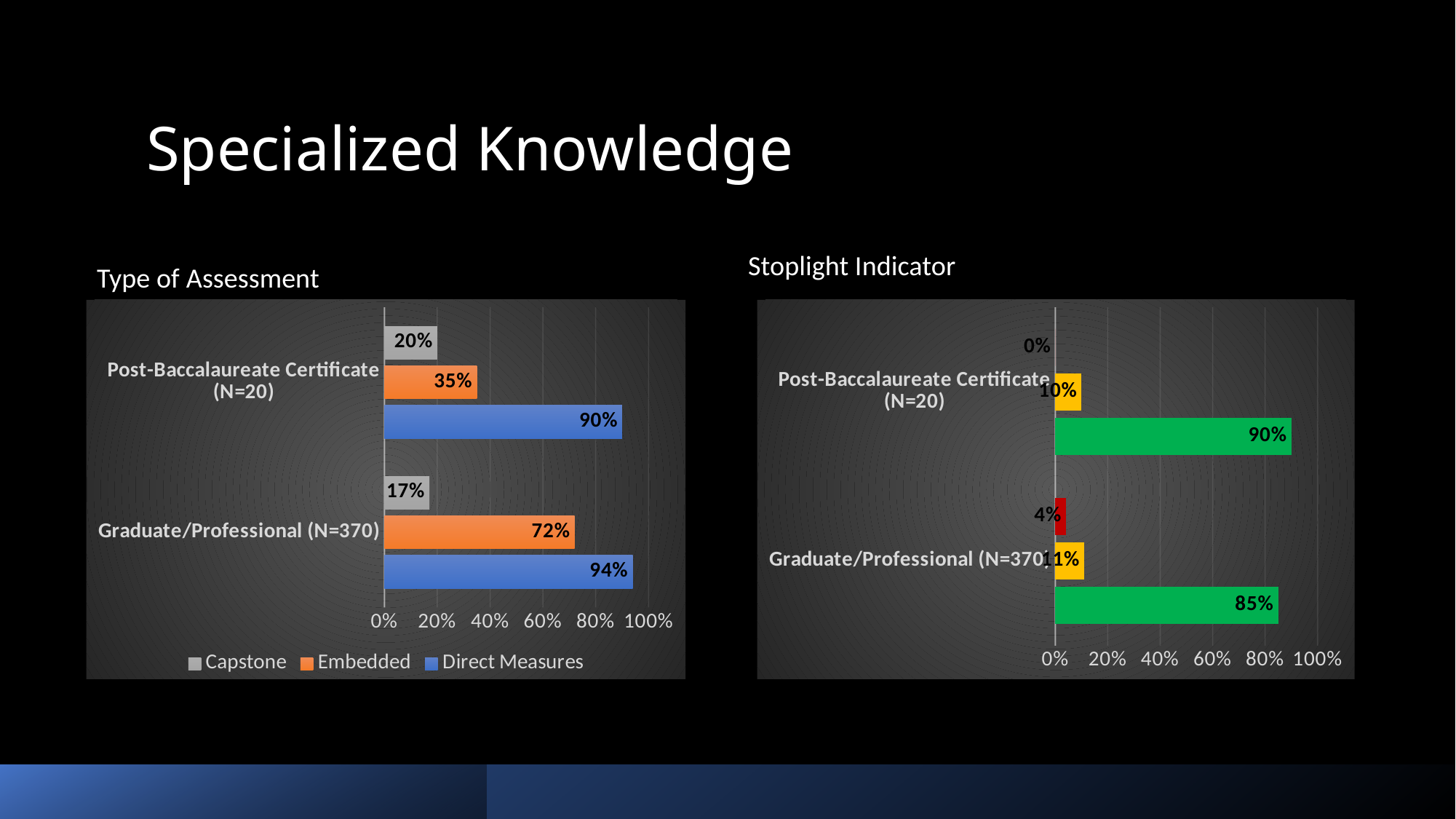
In the Stoplight Indicator chart, what is the value of the green bar for Graduate/Professional (N=370)? 85% In the Type of Assessment chart, what is the Direct Measures value for Graduate/Professional (N=370)? 94% In the Type of Assessment chart, how many series does the legend list? 3 How many categories are shown on the y axis of the Stoplight Indicator chart? 2 In the Stoplight Indicator chart, what is the value of the red bar for Post-Baccalaureate Certificate (N=20)? 0% In the Type of Assessment chart, what is the Embedded value for Post-Baccalaureate Certificate (N=20)? 35% What kind of chart is the Stoplight Indicator chart? bar chart In the Type of Assessment chart, is the Capstone value for Post-Baccalaureate Certificate (N=20) larger or smaller than the Capstone value for Graduate/Professional (N=370)? larger In the Stoplight Indicator chart, what is the difference between the green bar values for Post-Baccalaureate Certificate (N=20) and Graduate/Professional (N=370)? 5% In the Type of Assessment chart, what is the Capstone value for Graduate/Professional (N=370)? 17% In the Type of Assessment chart, which series has the highest value for Post-Baccalaureate Certificate (N=20)? Direct Measures In the Type of Assessment chart, what is the difference between the Embedded values for Graduate/Professional (N=370) and Post-Baccalaureate Certificate (N=20)? 37%